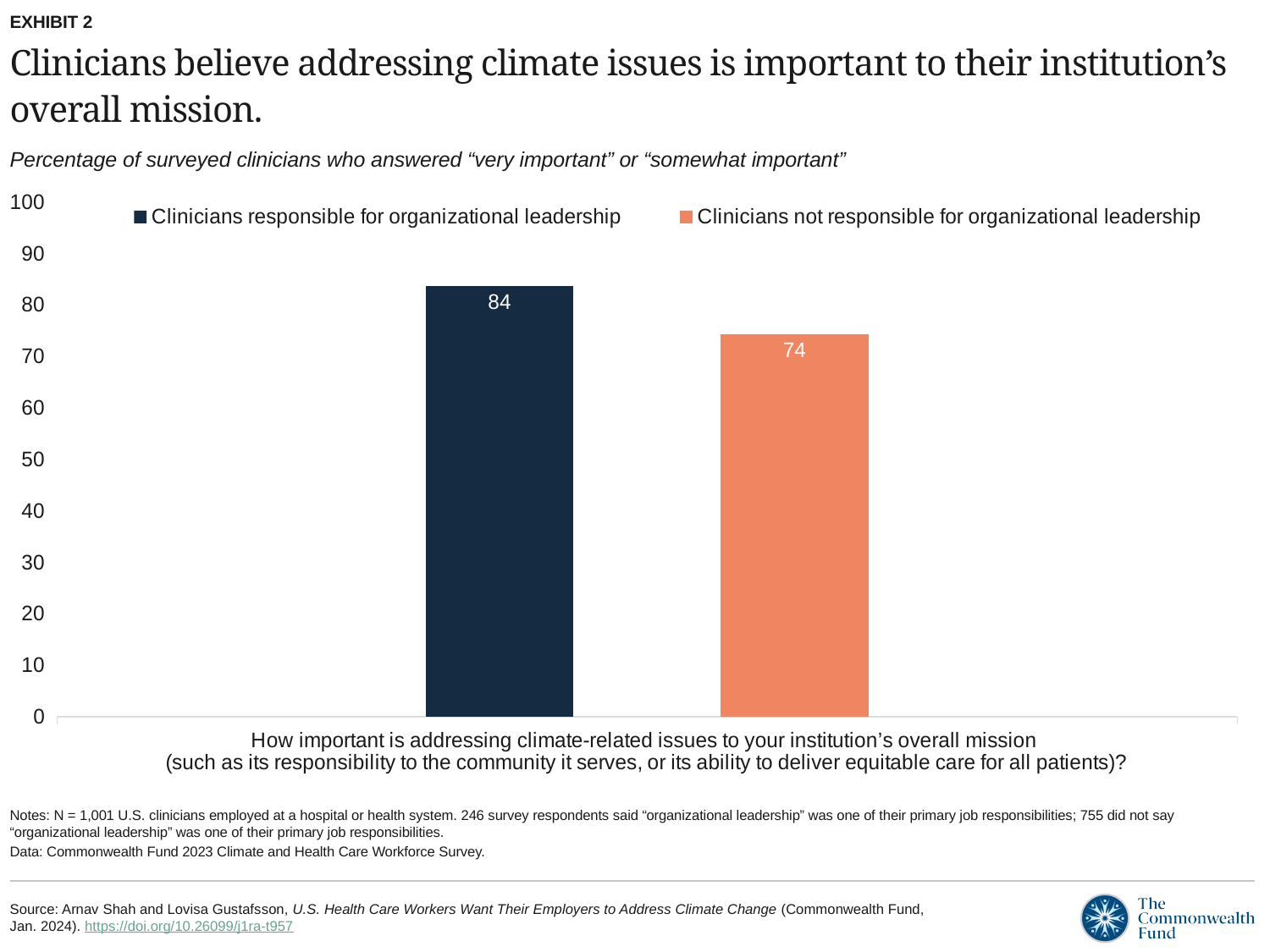
Is the value for clinicians responsible for organizational leadership greater or less than 80? greater Is the value for clinicians not responsible for organizational leadership greater or less than 80? less What percentage of clinicians not responsible for organizational leadership answered "very important" or "somewhat important"? 74 Which group has the lower value on the chart? Clinicians not responsible for organizational leadership What colour is the bar for clinicians not responsible for organizational leadership? Orange What kind of chart is shown on the slide? Bar chart What percentage of clinicians responsible for organizational leadership answered "very important" or "somewhat important"? 84 Which group has the higher value: clinicians responsible for organizational leadership or clinicians not responsible for organizational leadership? Clinicians responsible for organizational leadership How many series does the legend list? 2 Is the value for clinicians not responsible for organizational leadership larger or smaller than the value for clinicians responsible for organizational leadership? smaller How many bars are plotted on the chart? 2 What is the difference between the values for clinicians responsible for organizational leadership and clinicians not responsible for organizational leadership? 10